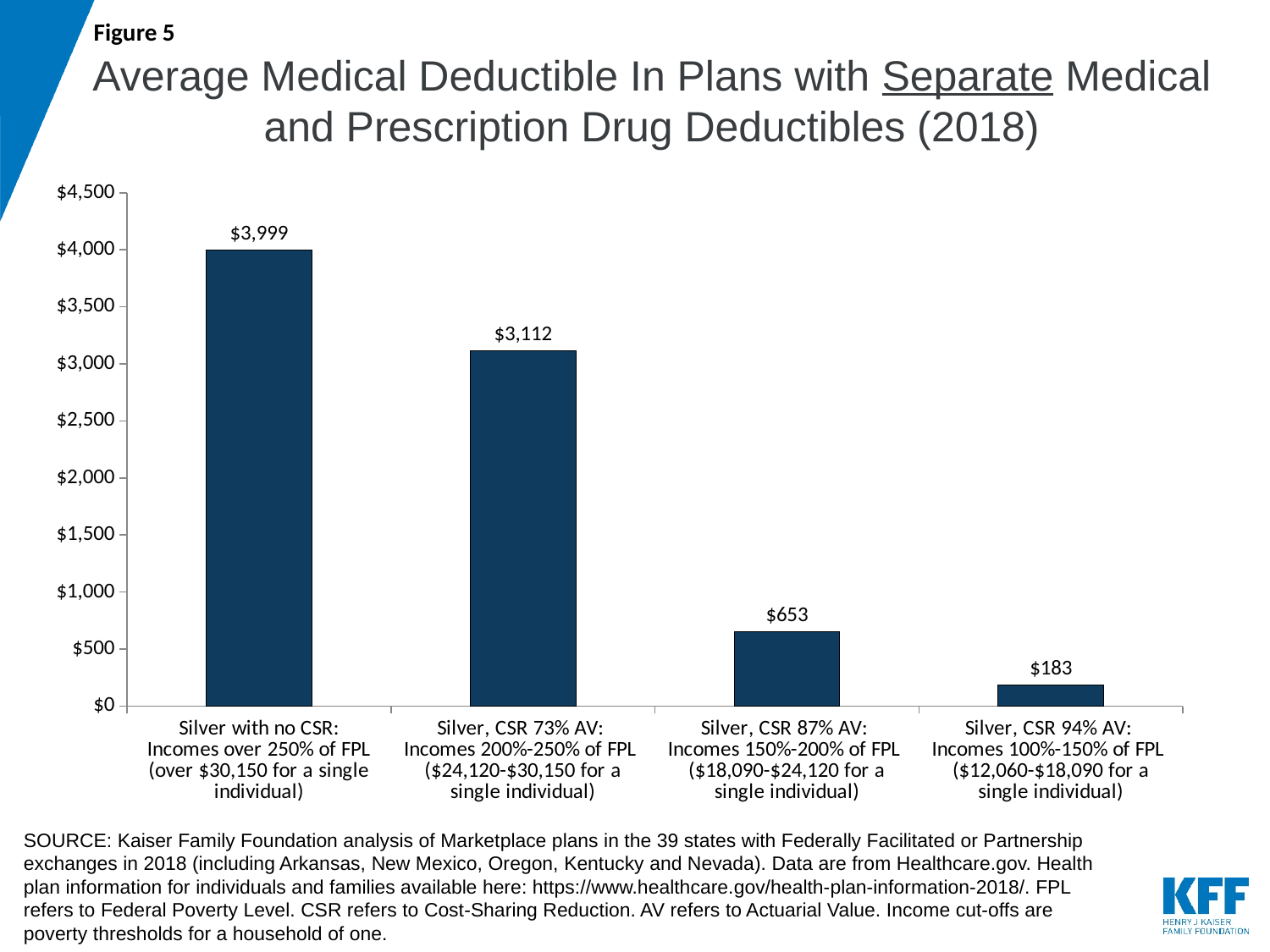
What is the average medical deductible for Silver, CSR 73% AV plans? $3,112 Which is larger, the average medical deductible for Silver, CSR 73% AV or Silver, CSR 87% AV? Silver, CSR 73% AV Which plan category has the lowest average medical deductible? Silver, CSR 94% AV What kind of chart is shown on the slide? Bar chart Do the average medical deductibles rise or fall moving from left to right across the categories? Fall What is the average medical deductible for Silver, CSR 94% AV plans? $183 What is the average medical deductible for Silver plans with no CSR? $3,999 What is the average medical deductible for Silver, CSR 87% AV plans? $653 What is the difference between the average medical deductible for Silver with no CSR and Silver, CSR 73% AV? $887 Which plan category has the highest average medical deductible? Silver with no CSR What is the difference between the average medical deductible for Silver, CSR 87% AV and Silver, CSR 94% AV? $470 How many plan categories are shown in the chart? 4